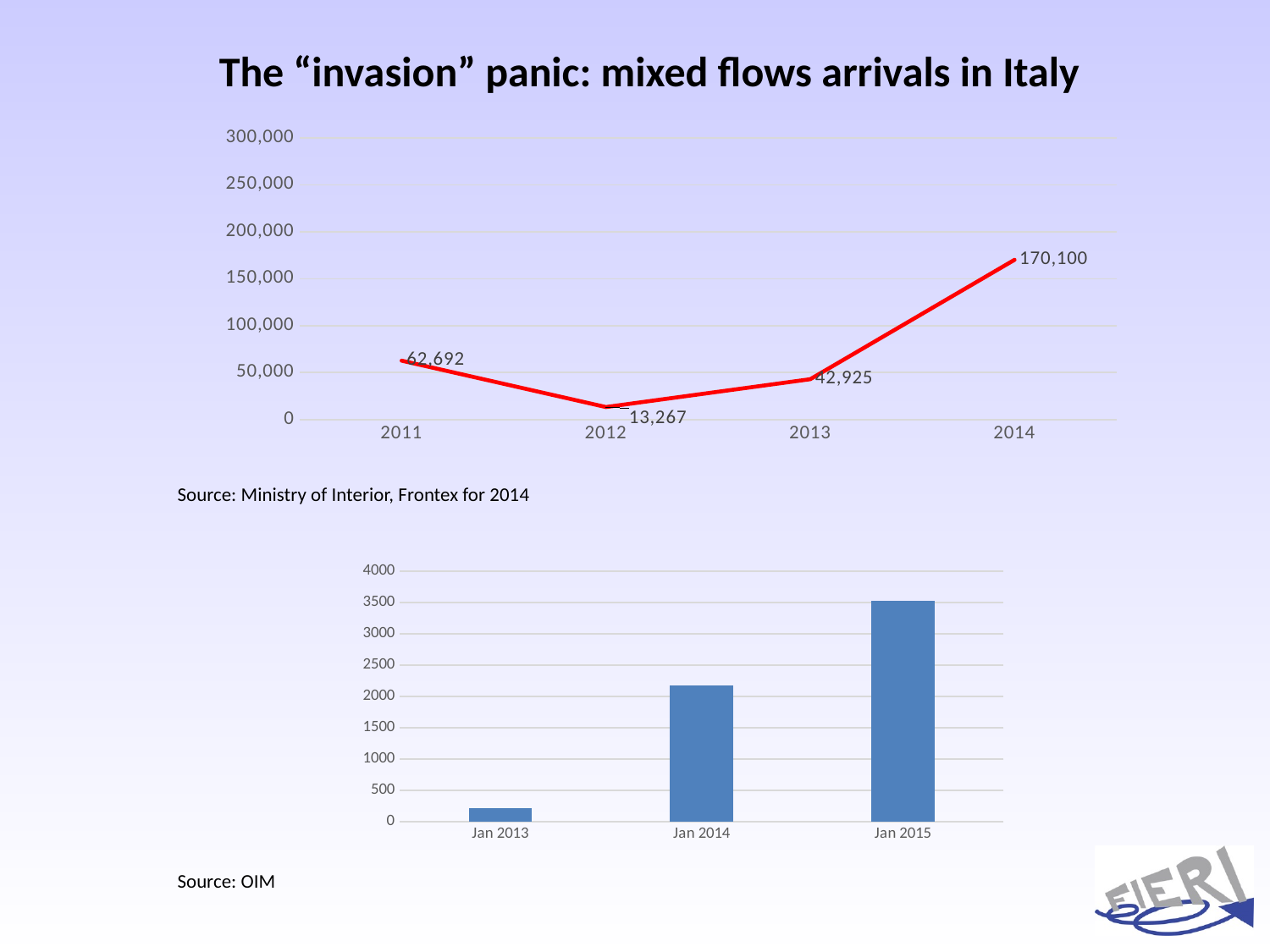
In the top line chart, what is the value for 2012? 13,267 In the top line chart, which year has the lowest value? 2012 In the top line chart, which is larger, the value for 2011 or the value for 2013? 2011 In the top line chart, what is the difference between the values for 2014 and 2013? 127,175 What kind of chart is the bottom chart on the slide? Bar chart How many data points are plotted in the top line chart? 4 In the top line chart, what is the value for 2011? 62,692 In the top line chart, which year has the highest value? 2014 In the top line chart, what is the value for 2014? 170,100 In the bottom bar chart, do the values rise or fall from Jan 2013 to Jan 2015? Rise In the bottom bar chart, is the value for Jan 2013 greater or less than 500? less In the bottom bar chart, is the value for Jan 2015 greater or less than 3000? greater